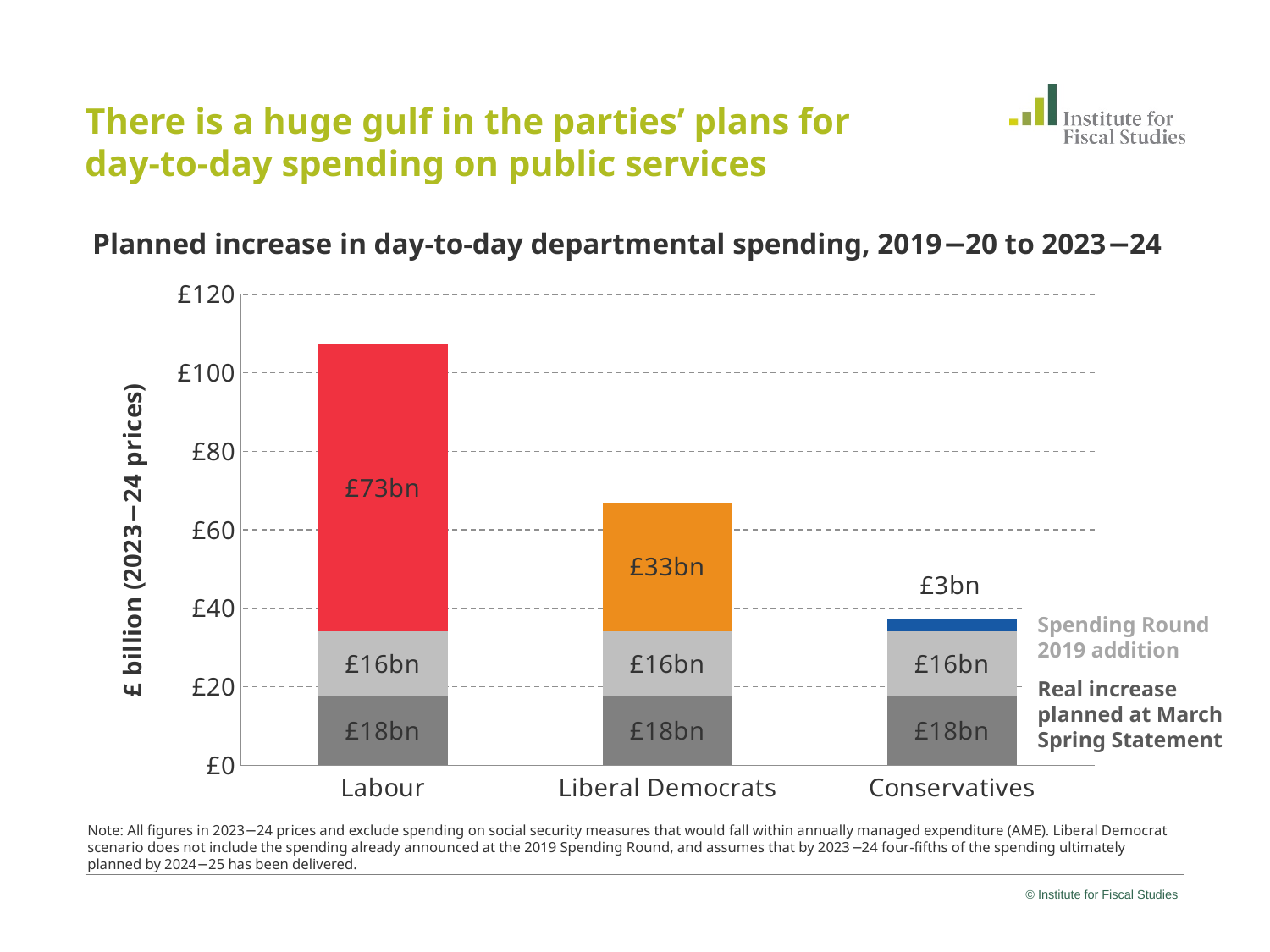
How much larger is Labour's top segment (£73bn) than the Liberal Democrats' top segment (£33bn)? £40bn Is the total height of the Liberal Democrats bar greater or less than £60? greater What is the total of the Conservatives stacked bar? £37bn How many parties are shown on the x axis? 3 What is the value of the blue segment at the top of the Conservatives bar? £3bn Which party has the tallest bar? Labour What is the value of the top (red) segment of the Labour bar? £73bn What is the total of the Labour stacked bar? £107bn What is the real increase planned at the March Spring Statement shown for Labour? £18bn What is the Spending Round 2019 addition shown for the Conservatives? £16bn Which party has the shortest bar? Conservatives What is the value of the orange segment of the Liberal Democrats bar? £33bn